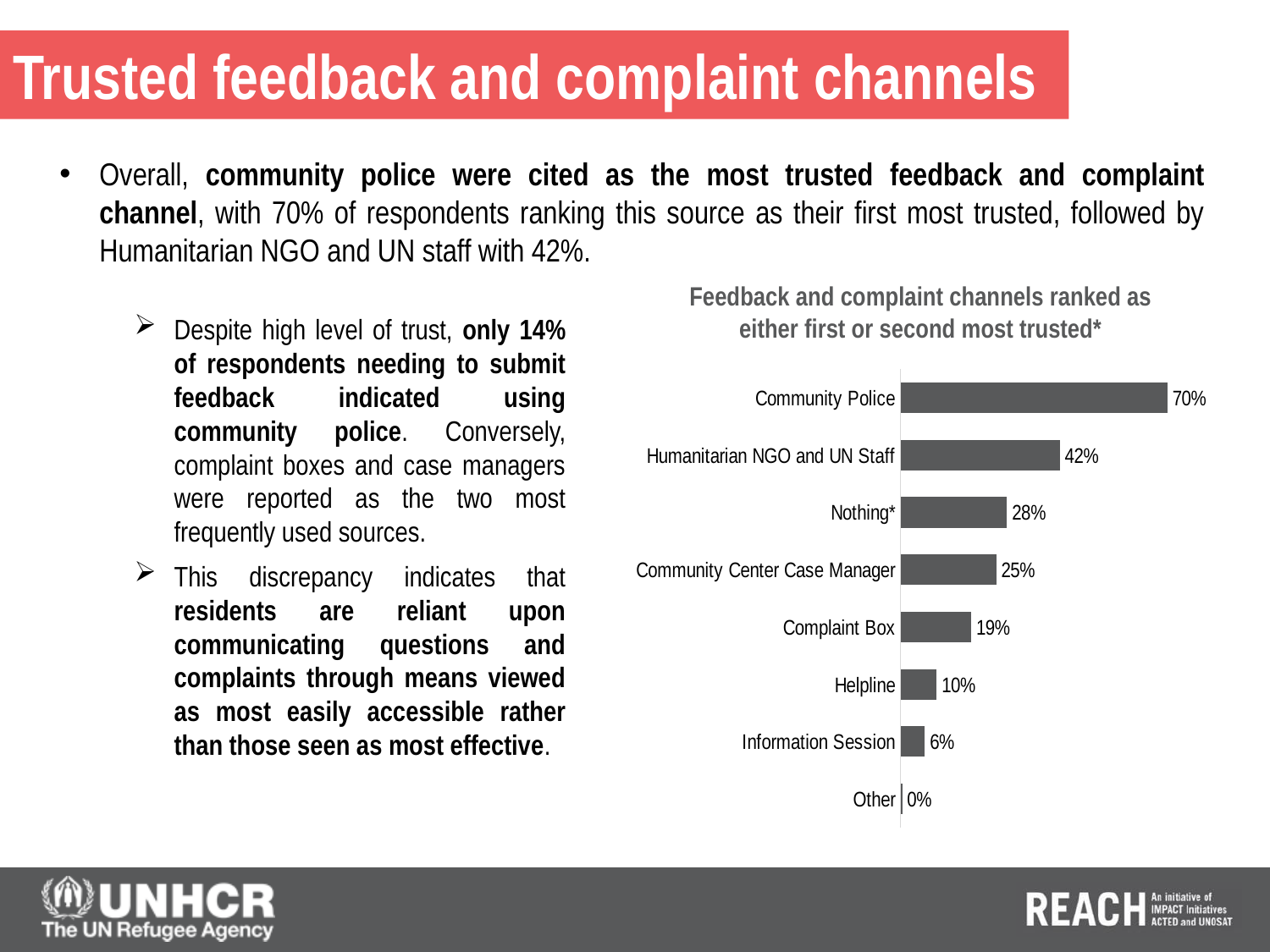
How many categories are shown in the chart? 8 Which has a larger value, Complaint Box or Helpline? Complaint Box What is the difference between the values for Community Police and Humanitarian NGO and UN Staff? 28% What is the value shown for Helpline? 10% What is the value shown for Humanitarian NGO and UN Staff? 42% What type of chart is shown on the slide? Bar chart Which channel has the highest value in the chart? Community Police What is the value shown for Complaint Box? 19% Which category has the lowest value in the chart? Other What is the difference between the values for Nothing* and Community Center Case Manager? 3% What percentage of respondents ranked Community Police as either first or second most trusted? 70% What is the title of the chart? Feedback and complaint channels ranked as either first or second most trusted*